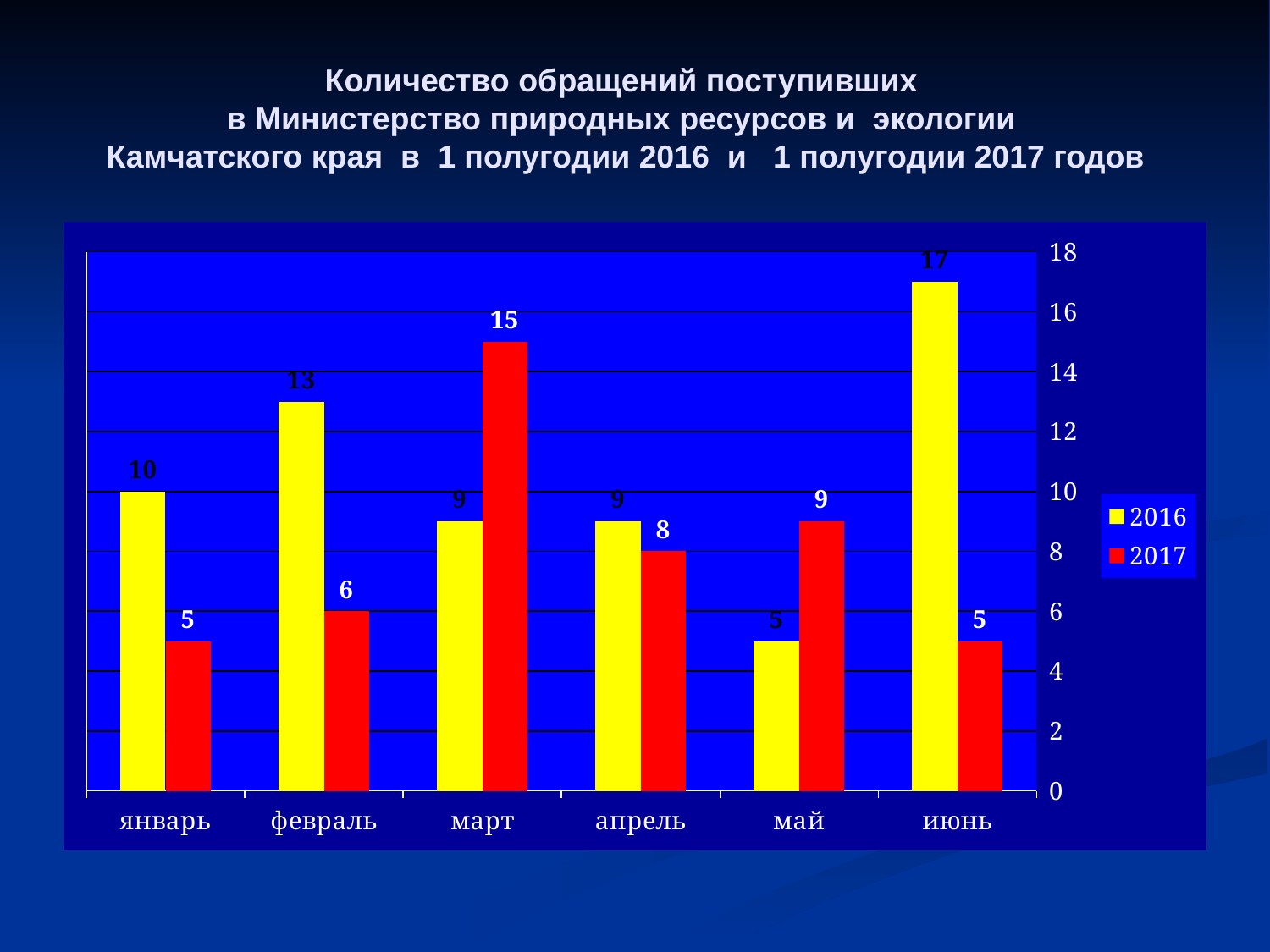
Which month has the lowest value for the 2017 series? январь and июнь (both 5) Which month has the highest value for the 2016 series? июнь What is the difference between the 2016 and 2017 values in февраль? 7 Is the 2016 value for июнь greater or less than 16? greater What kind of chart is shown on the slide? bar chart Which colour represents the 2017 series in the legend? red How many series does the legend list? 2 How many months are shown on the x axis? 6 What is the value for 2016 in май? 5 Which is larger in апрель: the 2016 value or the 2017 value? 2016 What is the value for 2016 in январь? 10 What is the value for 2017 in март? 15